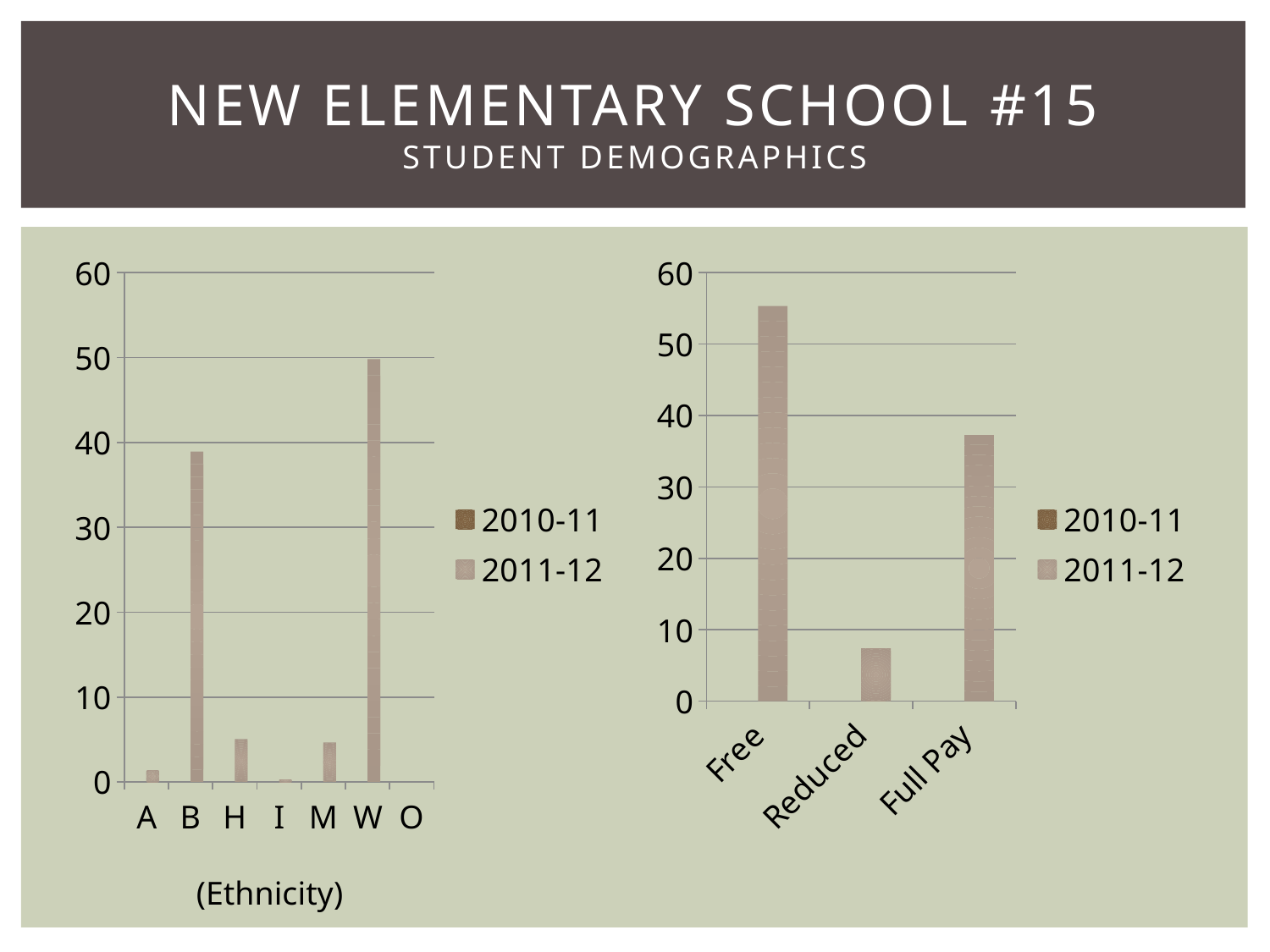
In the chart on the right, is the value for Free greater or less than 50? greater In the Ethnicity chart on the left, is the value for W greater or less than 40? greater What kind of chart is the chart on the right? bar chart In the Ethnicity chart on the left, how many series does the legend list? 2 In the Ethnicity chart on the left, is the value for B greater or less than 30? greater In the Ethnicity chart on the left, how many categories are shown on the x axis? 7 In the Ethnicity chart on the left, which is larger, the value for B or the value for W? W In the chart on the right, which category has the lowest value? Reduced In the chart on the right, which category has the highest value? Free In the Ethnicity chart on the left, which category has the highest value? W